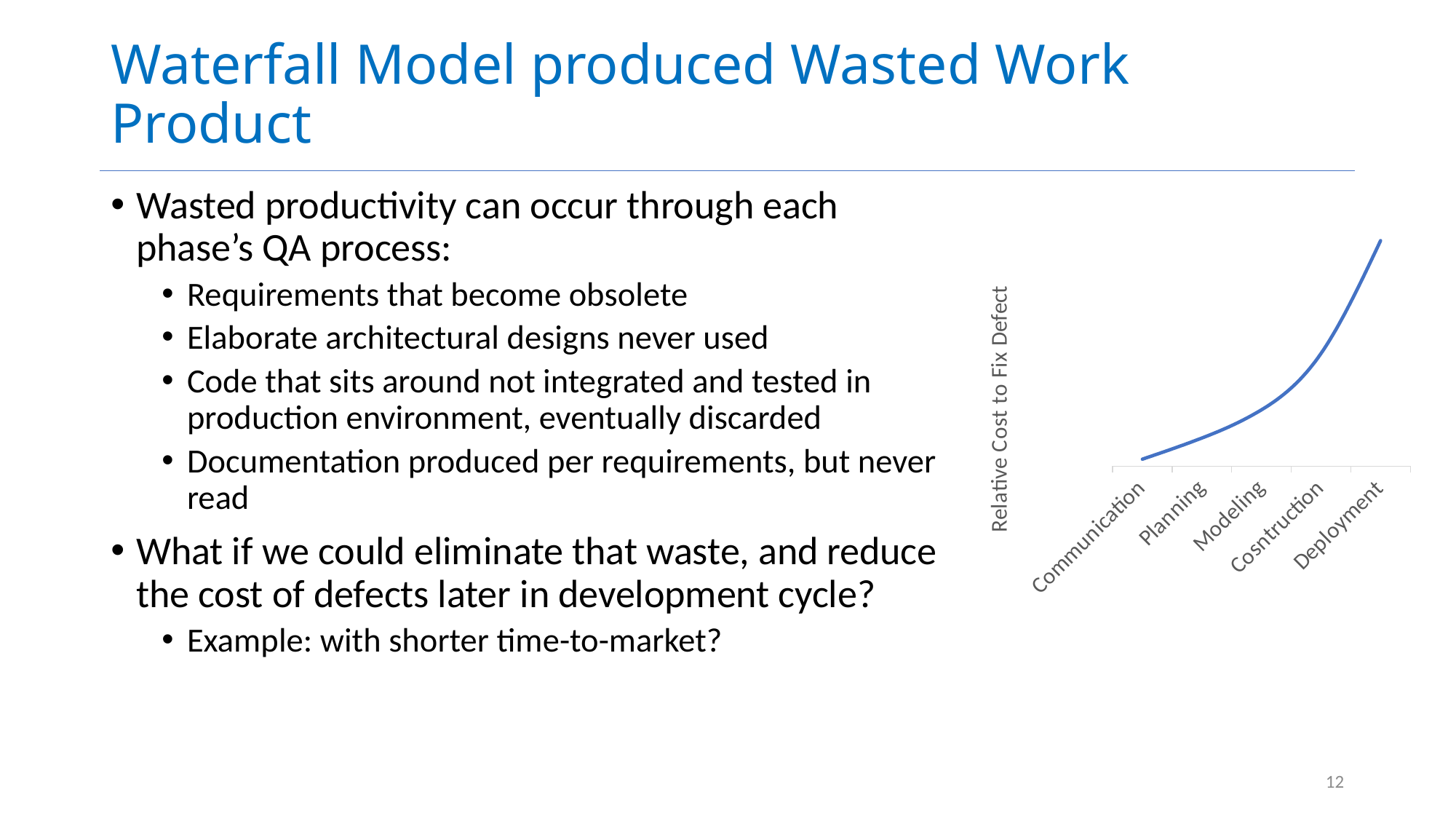
Which phase has the highest relative cost to fix a defect in the chart? Deployment Does the relative cost to fix a defect rise or fall from Communication to Deployment? rise What is the first phase listed on the x axis of the chart? Communication Which phase has the lowest relative cost to fix a defect in the chart? Communication What kind of chart is shown on the slide? line chart Which has a lower relative cost to fix a defect, Modeling or Deployment? Modeling What is the label on the vertical axis of the chart? Relative Cost to Fix Defect How many phases are labelled along the x axis of the chart? 5 Which has a higher relative cost to fix a defect, Planning or Construction? Construction